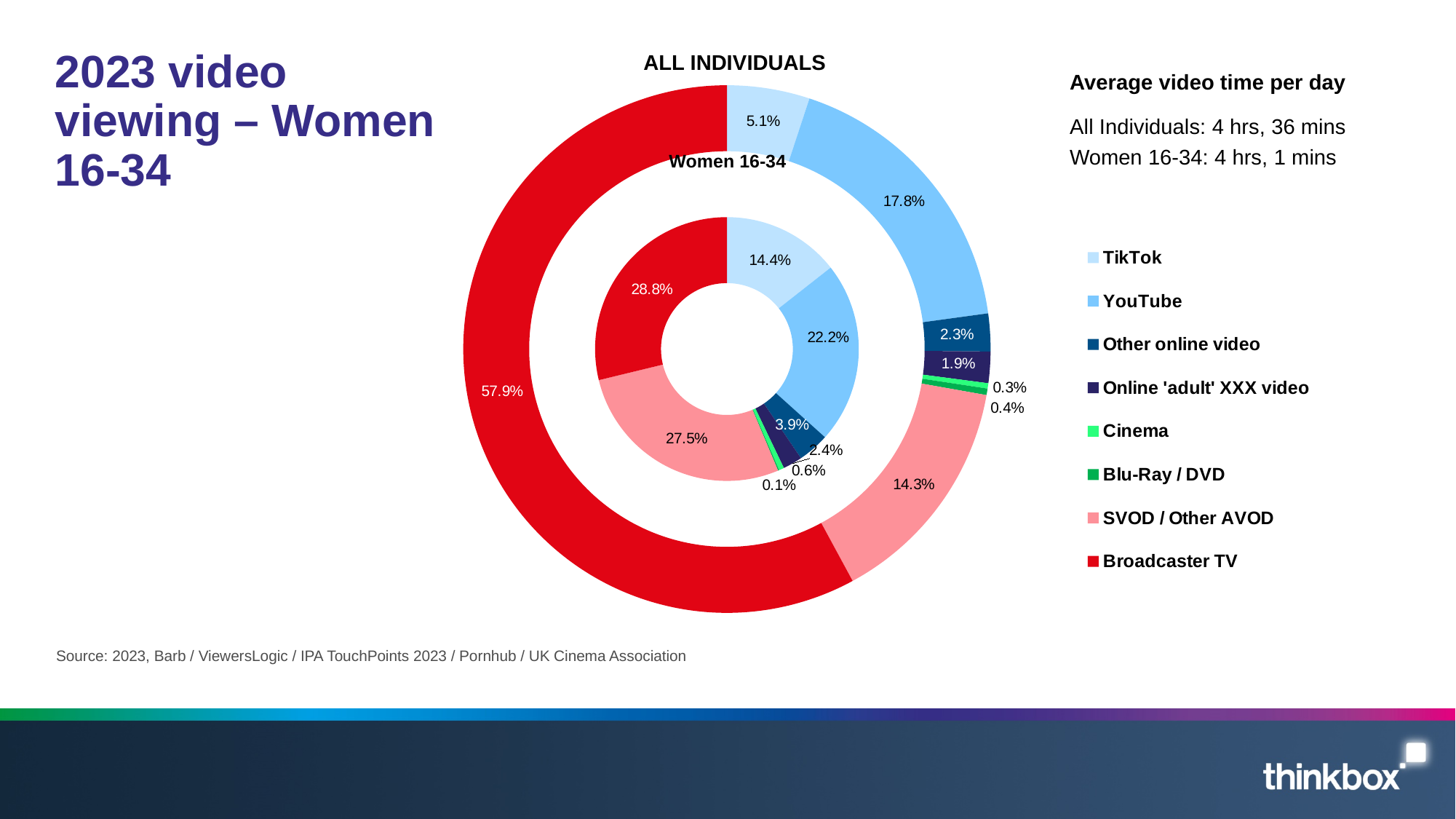
What is the difference between the TikTok share for Women 16-34 and for ALL INDIVIDUALS? 9.3 percentage points Which category has the largest share in the Women 16-34 ring? Broadcaster TV According to the text on the slide, what is the average video time per day for Women 16-34? 4 hrs, 1 mins Which is larger for Women 16-34: the TikTok share or the Other online video share? TikTok What kind of chart is shown on the slide? Doughnut chart In the ALL INDIVIDUALS ring, what share is SVOD / Other AVOD? 14.3% How many categories does the legend list? 8 In the ALL INDIVIDUALS ring, what share of video viewing is Broadcaster TV? 57.9% In the Women 16-34 ring, what share of video viewing is TikTok? 14.4% What is the difference between the Broadcaster TV share for ALL INDIVIDUALS and for Women 16-34? 29.1 percentage points Which category has the smallest share in the ALL INDIVIDUALS ring? Cinema In the Women 16-34 ring, what share of video viewing is YouTube? 22.2%